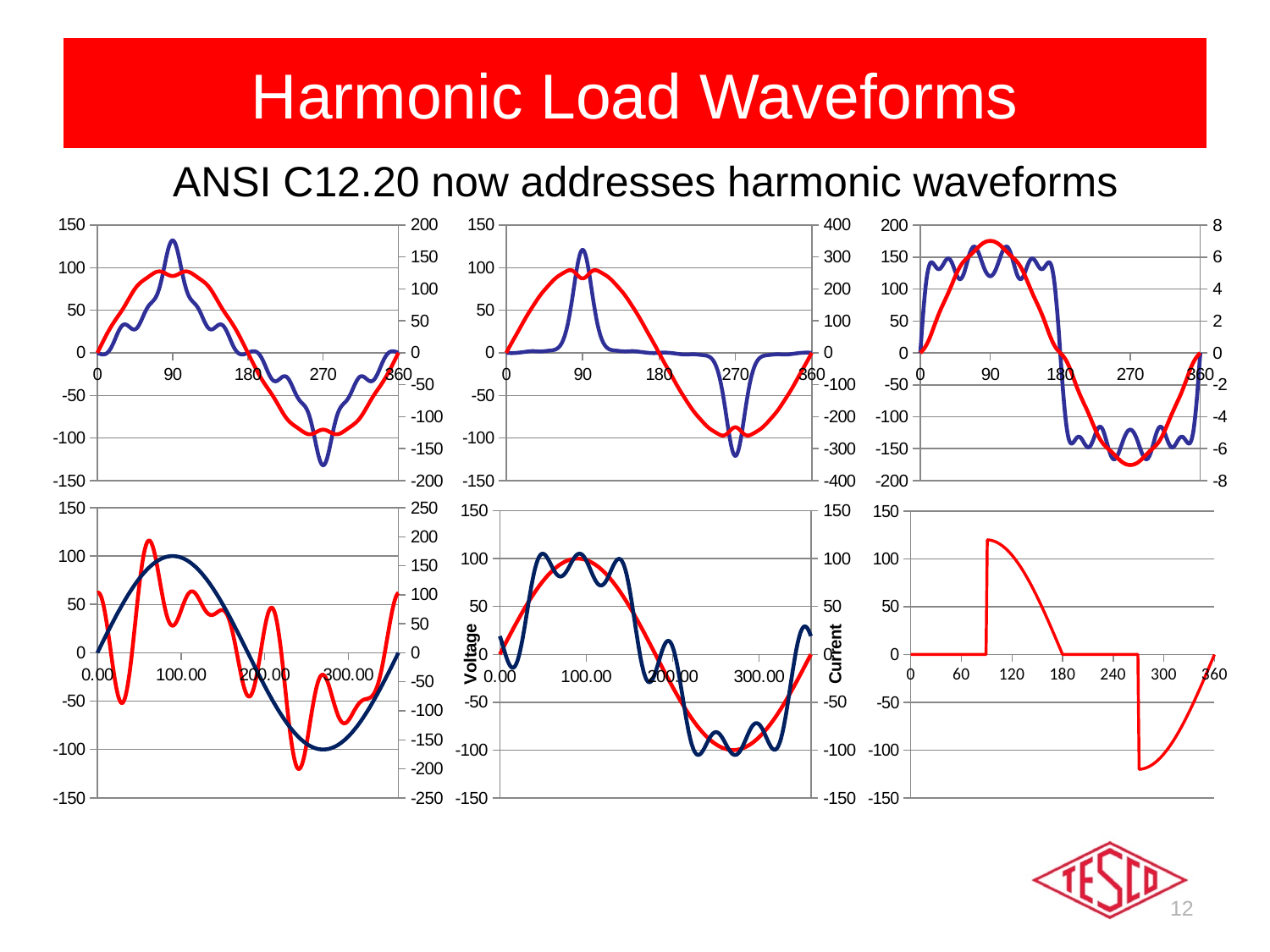
What kind of chart is the bottom-right chart on the slide? line chart In the bottom-middle chart, what is the label on the left vertical axis? Voltage In the top-middle chart, is the value of the blue line at 180 greater or less than 50? less In the bottom-right chart, does the red line rise or fall between 90 and 180 on the x axis? fall In the top-left chart, at which x-axis tick does the red line reach its highest value? 90 How many charts are shown on the slide? 6 In the top-right chart, at x = 90, which line is higher, the red line or the blue line? the red line In the bottom-right chart, is the peak value of the red line just after 90 greater or less than 100? greater In the top-right chart, is the value of the red line at 270 on the left axis greater or less than -100? less In the top-left chart, at x = 90, which line is higher, the red line or the blue line? the blue line